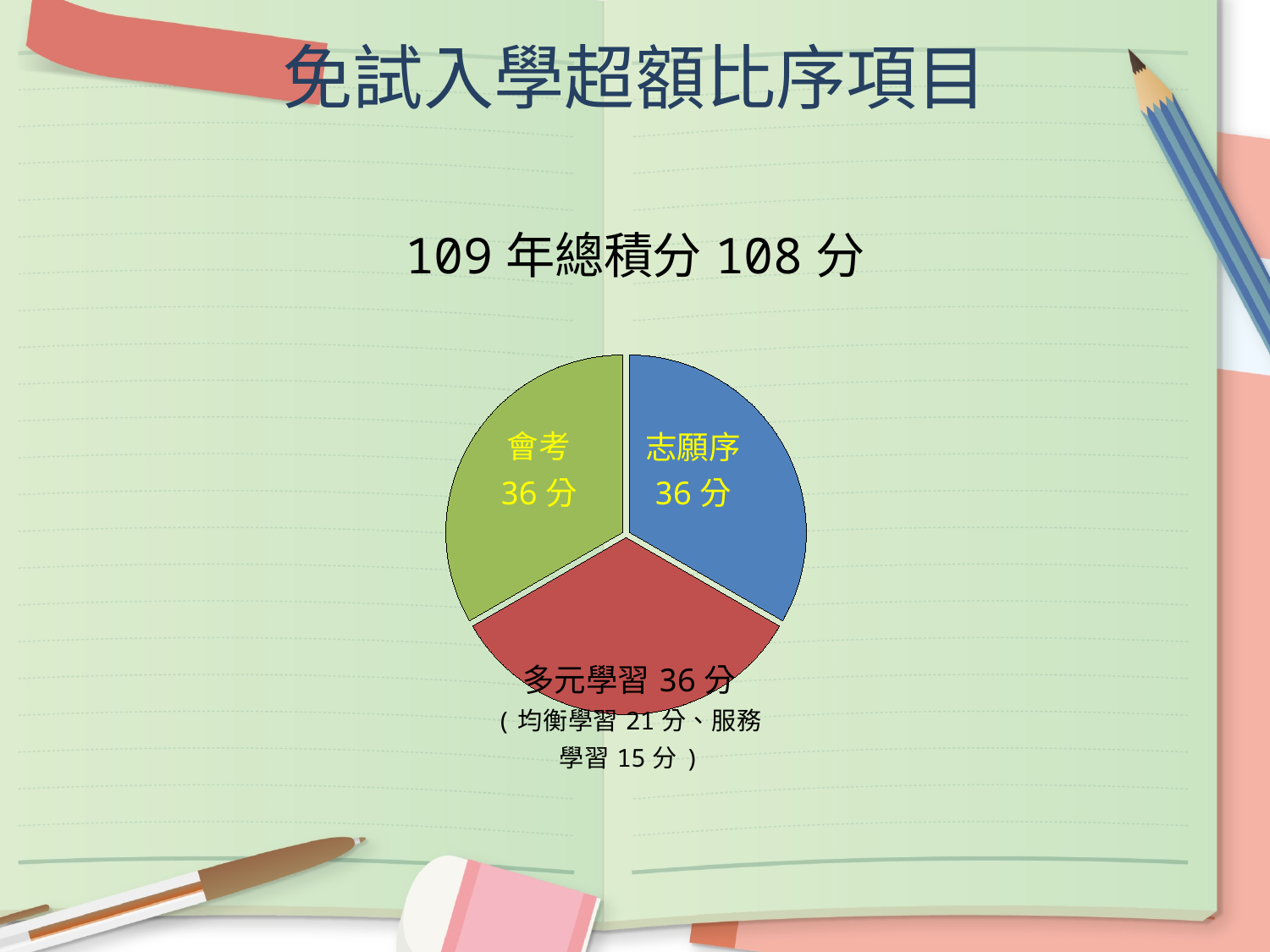
What kind of chart is shown on the slide? pie chart What is the difference between the 會考 value and the 志願序 value? 0 What is the total score shown above the pie chart for 109 年? 108 分 According to the note under the pie chart, how many points is 服務學習 worth? 15 分 What is the value shown for the 會考 slice? 36 分 According to the note under the pie chart, how many points is 均衡學習 worth? 21 分 How many slices does the pie chart have? 3 What share of the total 108 分 does the 志願序 slice represent? one third What is the value shown for the 志願序 slice? 36 分 Which colour is the 志願序 slice? blue Which colour is the 多元學習 slice? red What is the value shown for the 多元學習 slice? 36 分